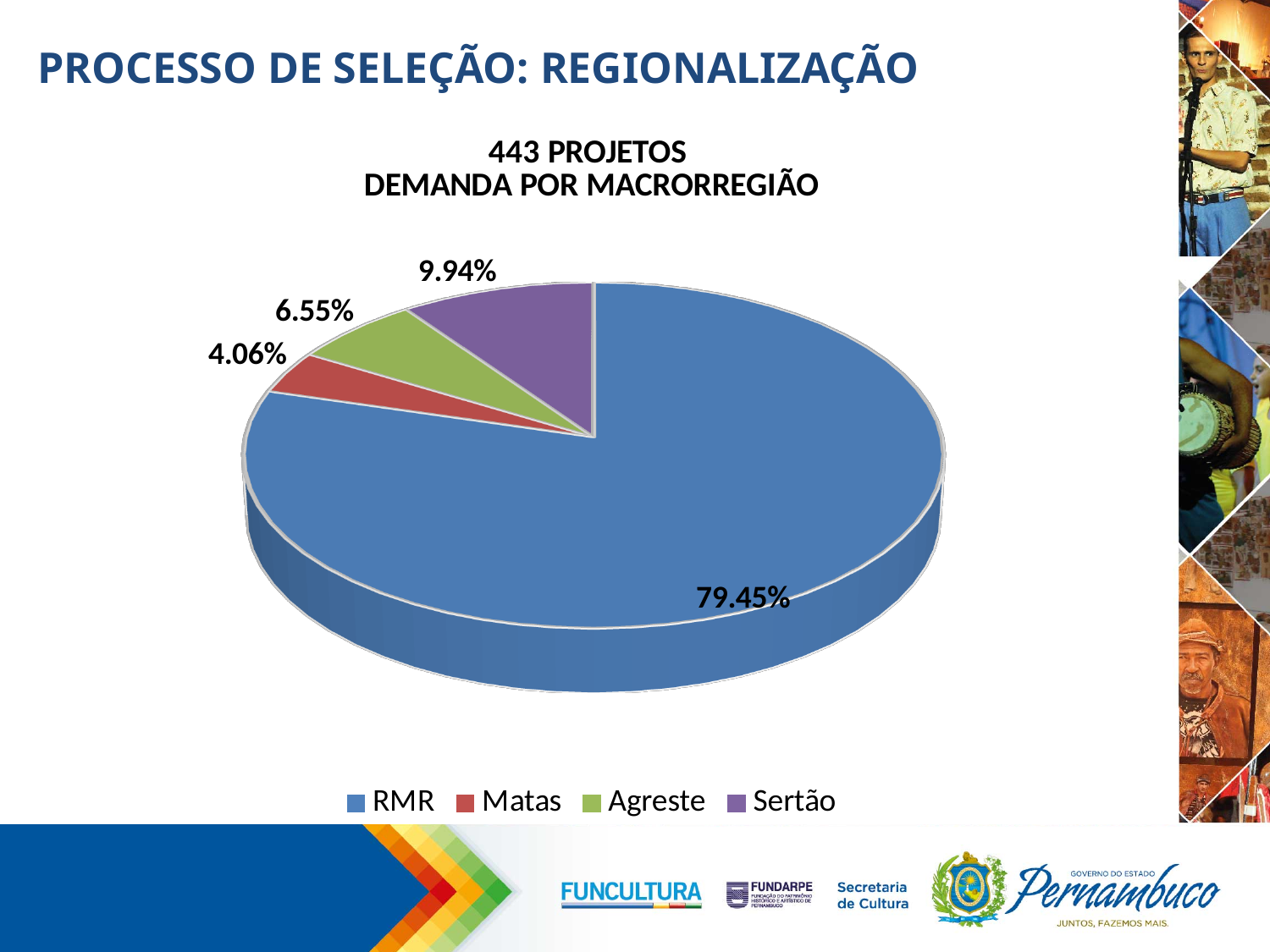
What is the title of the chart? 443 PROJETOS DEMANDA POR MACRORREGIÃO What share of the pie does RMR hold? 79.45% Which is larger, the share for Agreste or the share for Sertão? Sertão Which macroregion has the largest slice of the pie? RMR What kind of chart is shown on the slide? Pie chart What share of the pie does Agreste hold? 6.55% How many macroregions are shown in the pie chart? 4 Which colour represents Sertão in the legend? Purple Which macroregion has the smallest slice of the pie? Matas What is the difference in percentage points between the RMR share and the Sertão share? 69.51 What share of the pie does Sertão hold? 9.94%